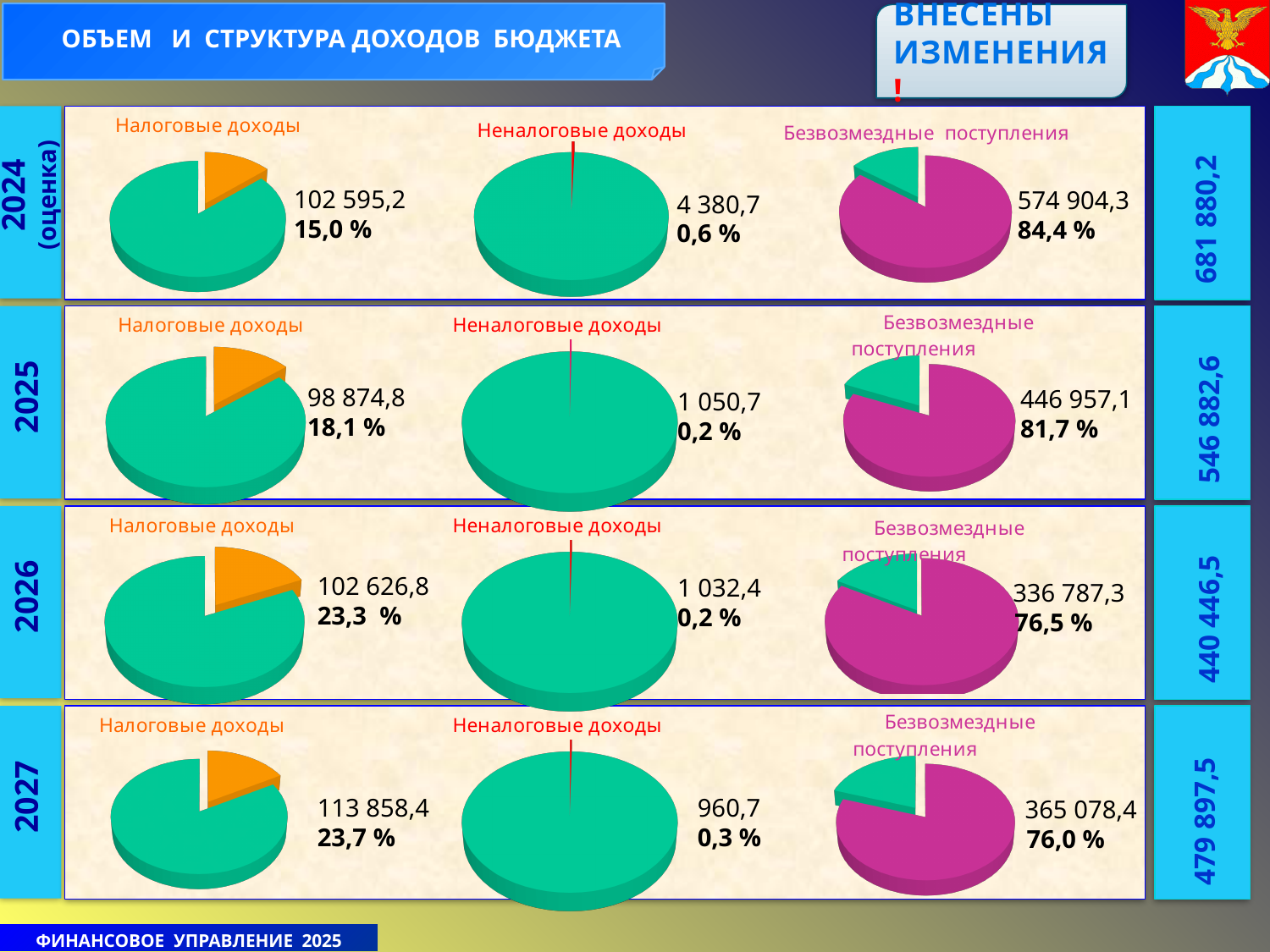
In the 2024 (оценка) row, what share of the pie do Безвозмездные поступления take? 84,4 % Which of the three revenue categories has the largest value in the 2027 row? Безвозмездные поступления In the 2025 row, what percentage is shown for Налоговые доходы? 18,1 % In the 2024 (оценка) row, what value is shown for Налоговые доходы? 102 595,2 Which of the three revenue categories has the smallest value in the 2026 row? Неналоговые доходы Is the value for Налоговые доходы larger in the 2027 row or in the 2026 row? 2027 In the 2025 row, what value is shown for Неналоговые доходы? 1 050,7 How many pie charts are shown on the slide? 12 In the 2026 row, what value is shown for Безвозмездные поступления? 336 787,3 What kind of charts are shown on the slide? Pie charts What is the difference between the Налоговые доходы values in the 2027 row and the 2026 row? 11 231,6 In the 2027 row, what percentage is shown for Неналоговые доходы? 0,3 %